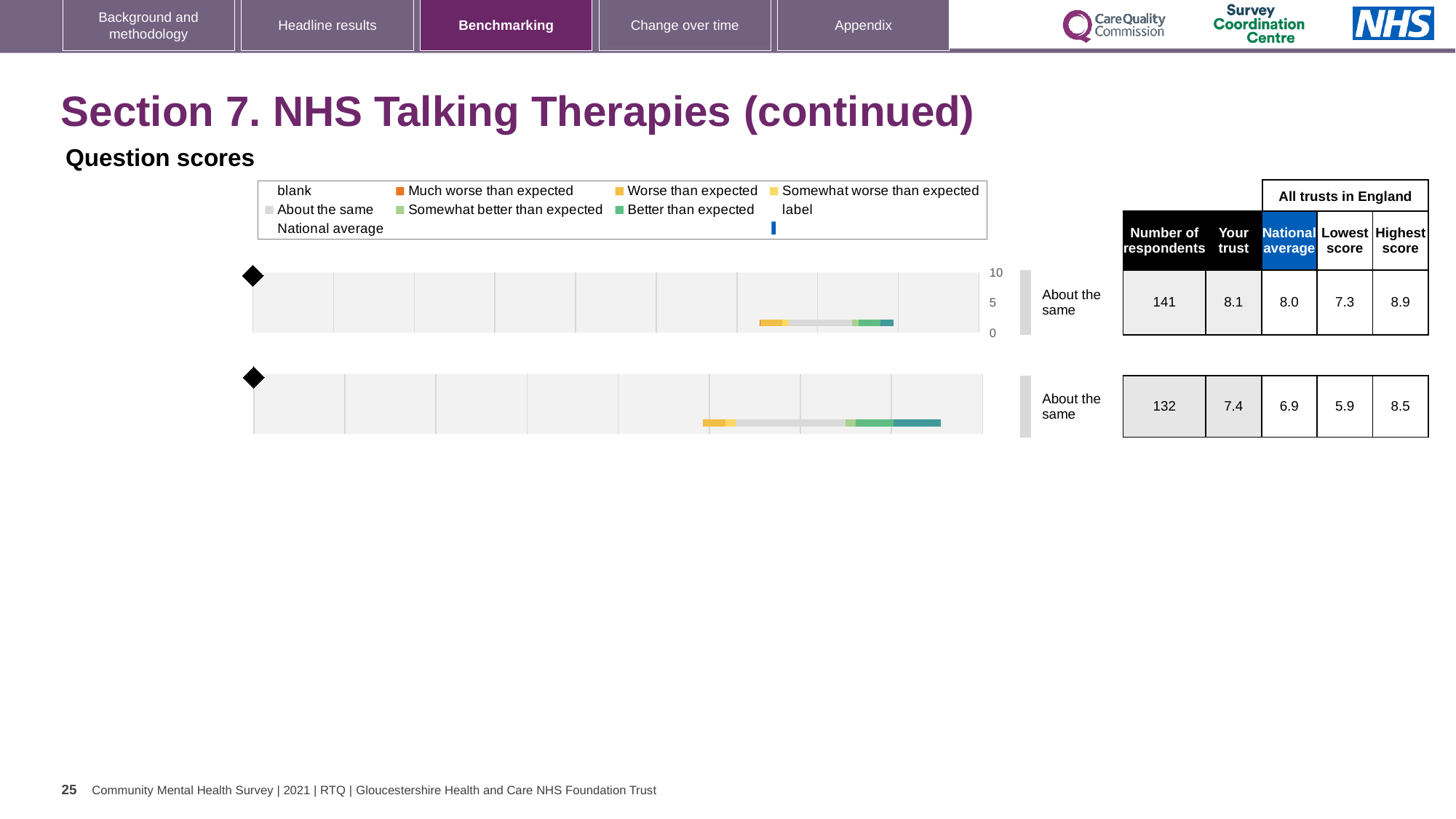
How many question-score charts are shown on the slide? 2 For the bottom chart, what is the difference between the 'Your trust' score and the national average? 0.5 For the top chart, what is the national average score shown in the table? 8.0 For the top chart, what is the 'Your trust' score shown in the table? 8.1 Which chart has the higher 'Your trust' score, the top chart or the bottom chart? top chart What kind of chart is used for the question scores on this slide? bar chart For the bottom chart, how many respondents are listed in the table? 132 What is the maximum value shown on the score axis of the top chart? 10 For the top chart, which is larger: the 'Your trust' score or the national average? Your trust What benchmark category is shown next to the bottom chart? About the same For the top chart, what is the difference between the highest score and the lowest score among all trusts in England? 1.6 For the bottom chart, what is the lowest score among all trusts in England? 5.9